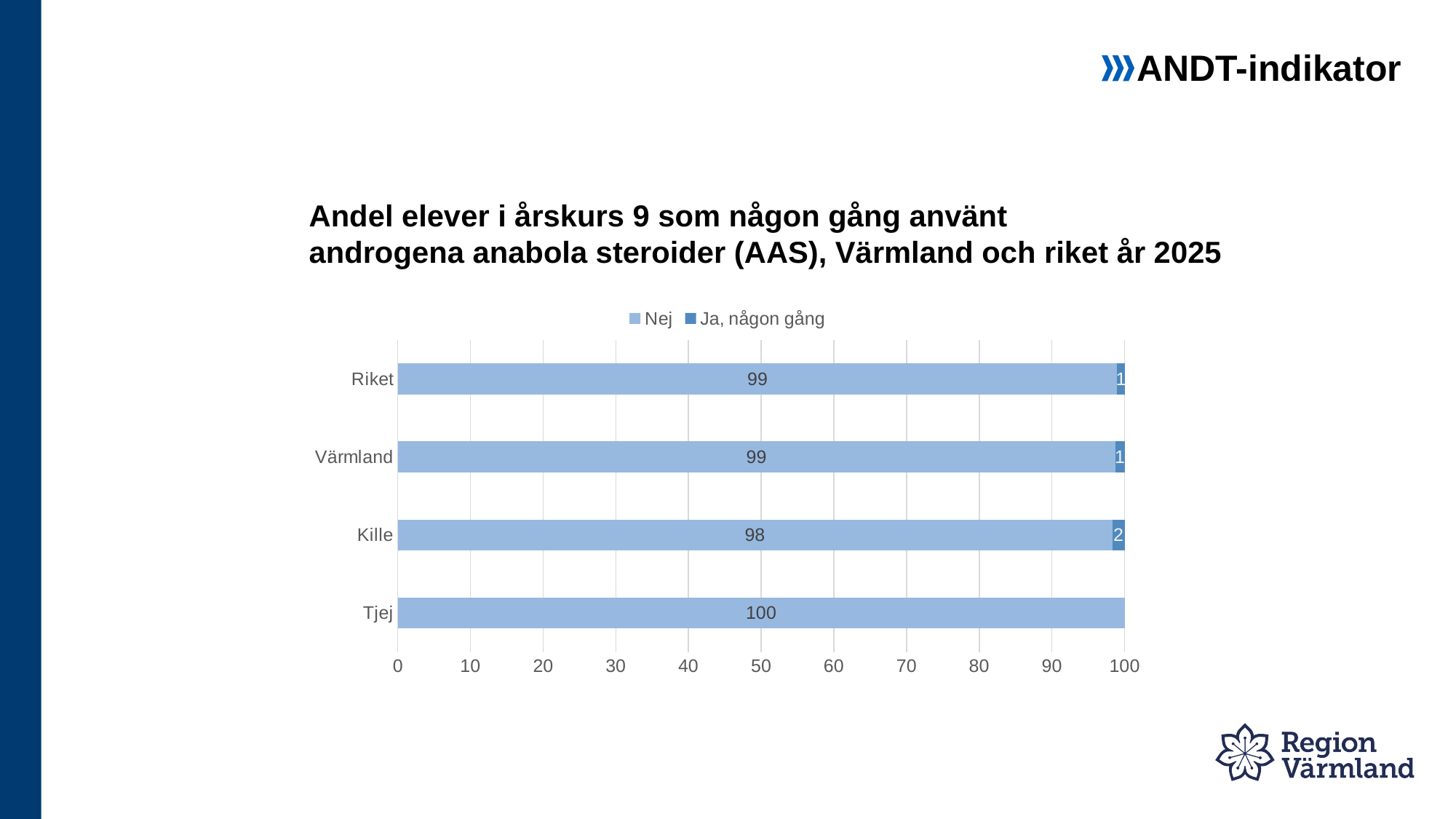
Which is larger, the "Ja, någon gång" value for Kille or for Riket? Kille What kind of chart is shown on the slide? Stacked bar chart Which category has the lowest "Nej" value? Kille What is the value of "Ja, någon gång" for Värmland? 1 What is the value of "Ja, någon gång" for Kille? 2 How many categories are shown on the y axis? 4 Which category has the highest "Nej" value? Tjej What is the value of "Nej" for Kille? 98 How many series does the legend list? 2 What is the value of "Nej" for Tjej? 100 What is the difference between the "Nej" values for Tjej and Kille? 2 What is the value of "Nej" for Riket? 99